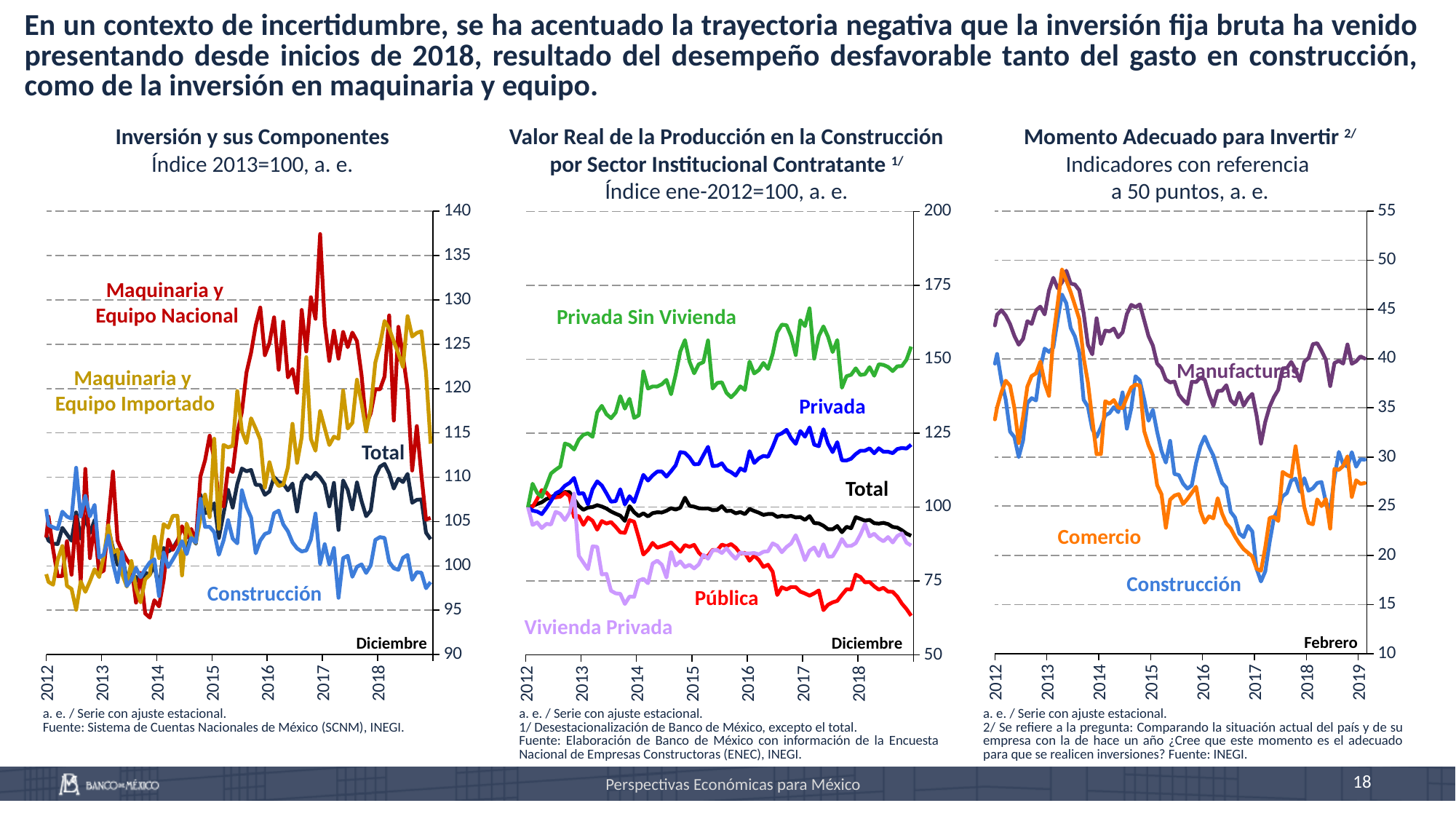
In the 'Momento Adecuado para Invertir' chart, is the value of Manufacturas at the end of the series (Febrero 2019) greater or less than 35? greater In the 'Valor Real de la Producción en la Construcción' chart, which series is highest at the end of 2018? Privada Sin Vivienda In the 'Inversión y sus Componentes' chart, is the peak value of Maquinaria y Equipo Nacional in 2017 greater or less than 135? greater How many series are plotted in the 'Inversión y sus Componentes' chart? 4 How many series are plotted in the 'Momento Adecuado para Invertir' chart? 3 What kind of chart is the 'Inversión y sus Componentes' chart? line chart In the 'Valor Real de la Producción en la Construcción' chart, is the value of Pública at the end of the series greater or less than 75? less In the 'Valor Real de la Producción en la Construcción' chart, does the Pública series rise or fall from 2012 to the end of 2018? fall What reference level do the indicators in the 'Momento Adecuado para Invertir' chart use, according to its subtitle? 50 puntos How many series are plotted in the 'Valor Real de la Producción en la Construcción por Sector Institucional Contratante' chart? 5 In the 'Inversión y sus Componentes' chart, which series is higher at the end of 2018: Total or Construcción? Total